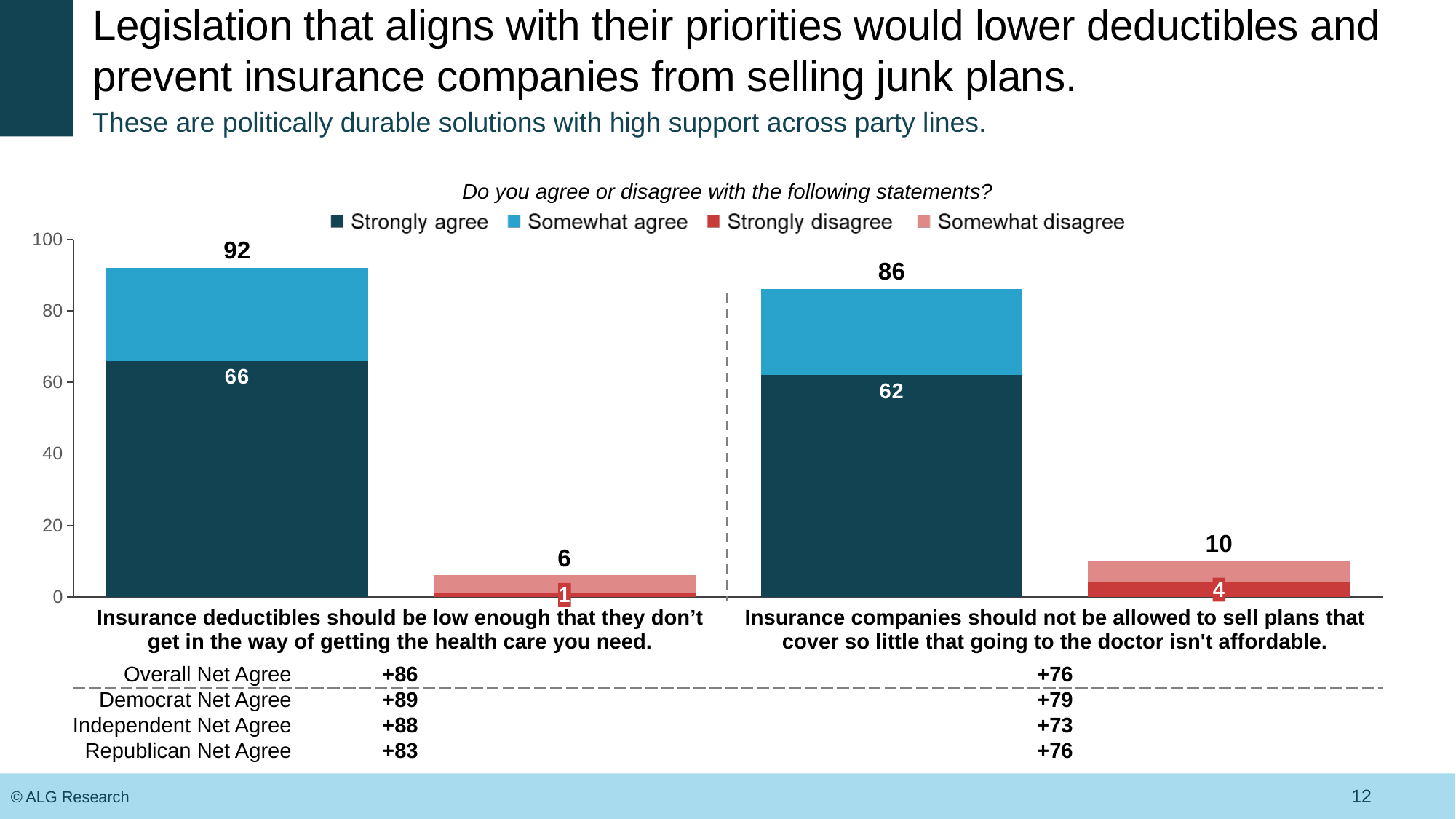
What is the Strongly agree value for the statement "Insurance companies should not be allowed to sell plans that cover so little that going to the doctor isn't affordable"? 62 What is the Republican Net Agree value for the statement about insurance deductibles? +83 Is the Strongly agree value for the statement about insurance companies selling plans that cover so little greater or less than 60? greater What is the total agree value for the statement "Insurance deductibles should be low enough that they don't get in the way of getting the health care you need"? 92 What kind of chart is shown on the slide? Stacked bar chart What is the total disagree value for the statement about insurance companies selling plans that cover so little? 10 What is the Strongly disagree value for the statement about insurance deductibles? 1 Which statement has the higher total agree value? Insurance deductibles should be low enough that they don't get in the way of getting the health care you need. How many series does the legend list? 4 What is the Somewhat agree value for the statement about insurance deductibles, given total agree of 92 and Strongly agree of 66? 26 What is the difference between the total agree values for the two statements (92 and 86)? 6 What question is shown as the chart's title above the legend? Do you agree or disagree with the following statements?